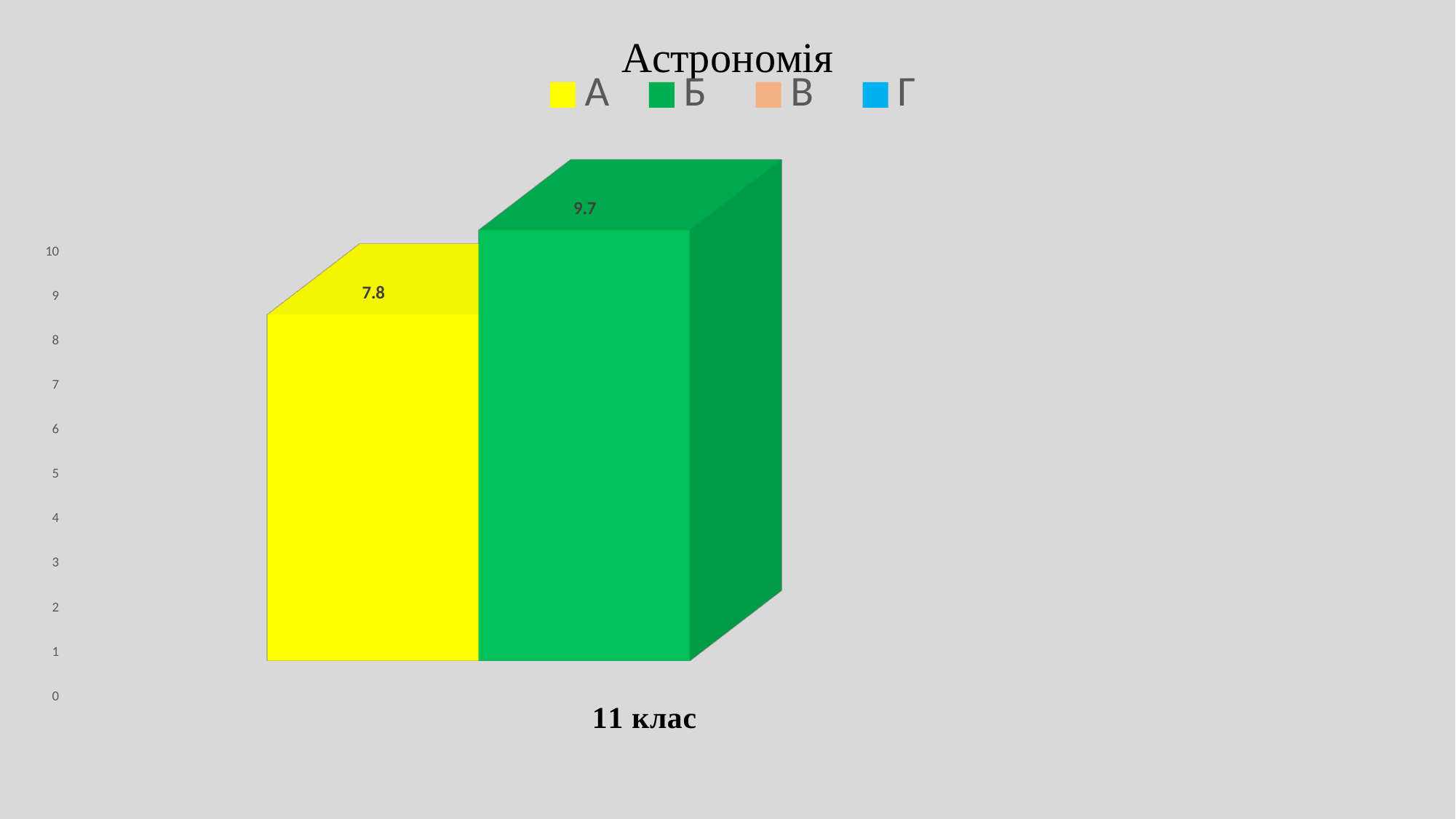
What is the value for series Б in the chart? 9.7 What is the title of the chart? Астрономія What kind of chart is shown on the slide? bar chart What is the category label shown on the x axis? 11 клас Is the value for А greater or less than 8? less Which is larger, the value for А or the value for Б? Б Which series has the highest value in the chart? Б Is the value for Б greater or less than 9? greater Which of the plotted series has the lowest value in the chart? А What is the value for series А in the chart? 7.8 What is the difference between the values for Б and А? 1.9 How many series does the legend list? 4